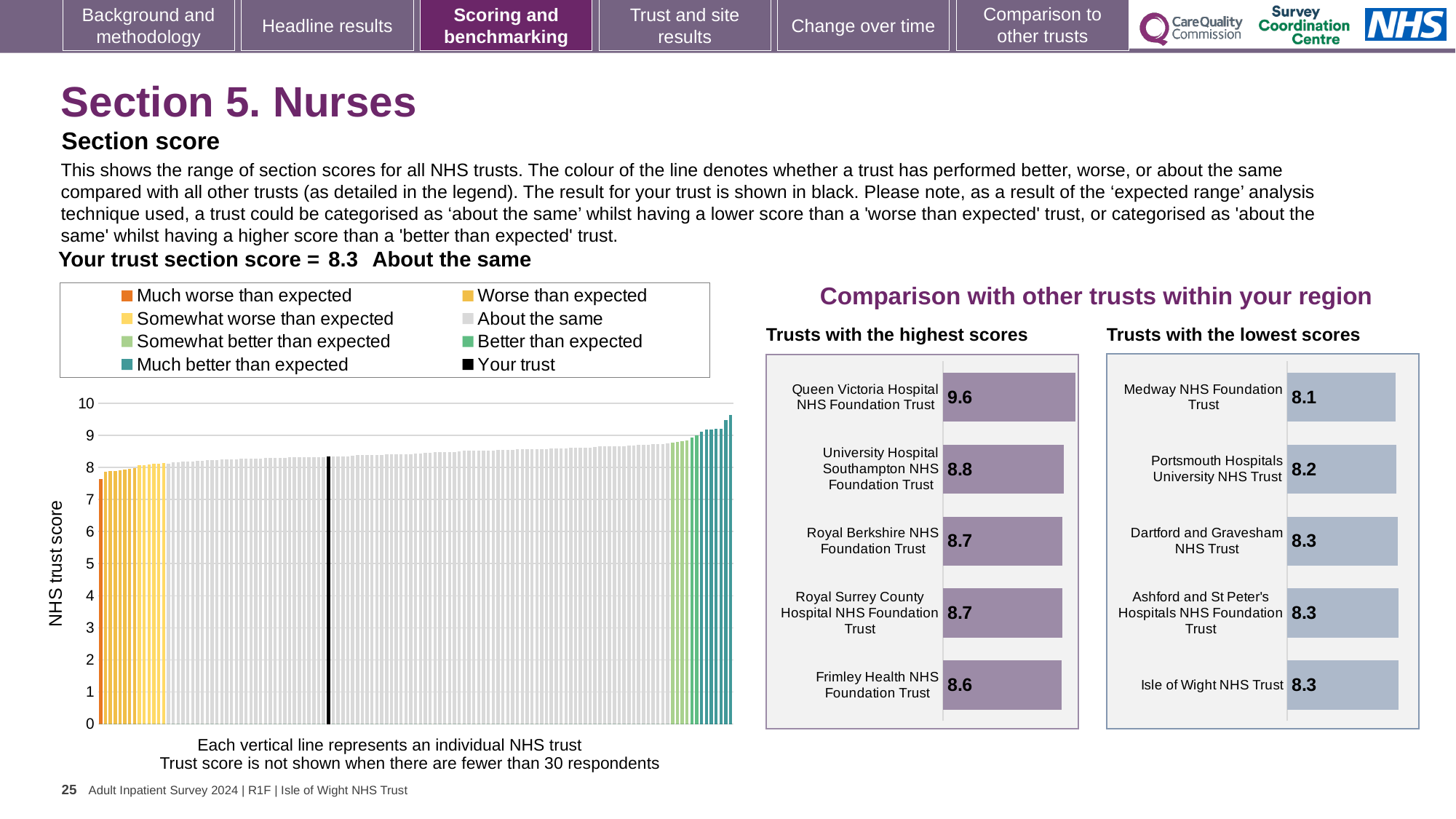
How many entries does the legend of the large 'NHS trust score' chart on the left list? 8 What kind of chart is the 'Trusts with the lowest scores' chart? bar chart In the 'Trusts with the lowest scores' chart, what is the score for Isle of Wight NHS Trust? 8.3 In the 'Trusts with the lowest scores' chart, which trust has the lowest score? Medway NHS Foundation Trust In the 'Trusts with the highest scores' chart, what is the difference between the scores of Queen Victoria Hospital NHS Foundation Trust and University Hospital Southampton NHS Foundation Trust? 0.8 In the 'Trusts with the highest scores' chart, which trust has the highest score? Queen Victoria Hospital NHS Foundation Trust In the 'Trusts with the lowest scores' chart, which has the larger score: Medway NHS Foundation Trust or Portsmouth Hospitals University NHS Trust? Portsmouth Hospitals University NHS Trust How many trusts are shown in the 'Trusts with the highest scores' chart? 5 In the 'Trusts with the highest scores' chart, what is the score for Frimley Health NHS Foundation Trust? 8.6 In the 'Trusts with the highest scores' chart, what is the score for Queen Victoria Hospital NHS Foundation Trust? 9.6 In the large 'NHS trust score' chart on the left, do the bar heights rise or fall from left to right? rise In the large 'NHS trust score' chart on the left, is the value for the black 'Your trust' bar greater or less than 5? greater